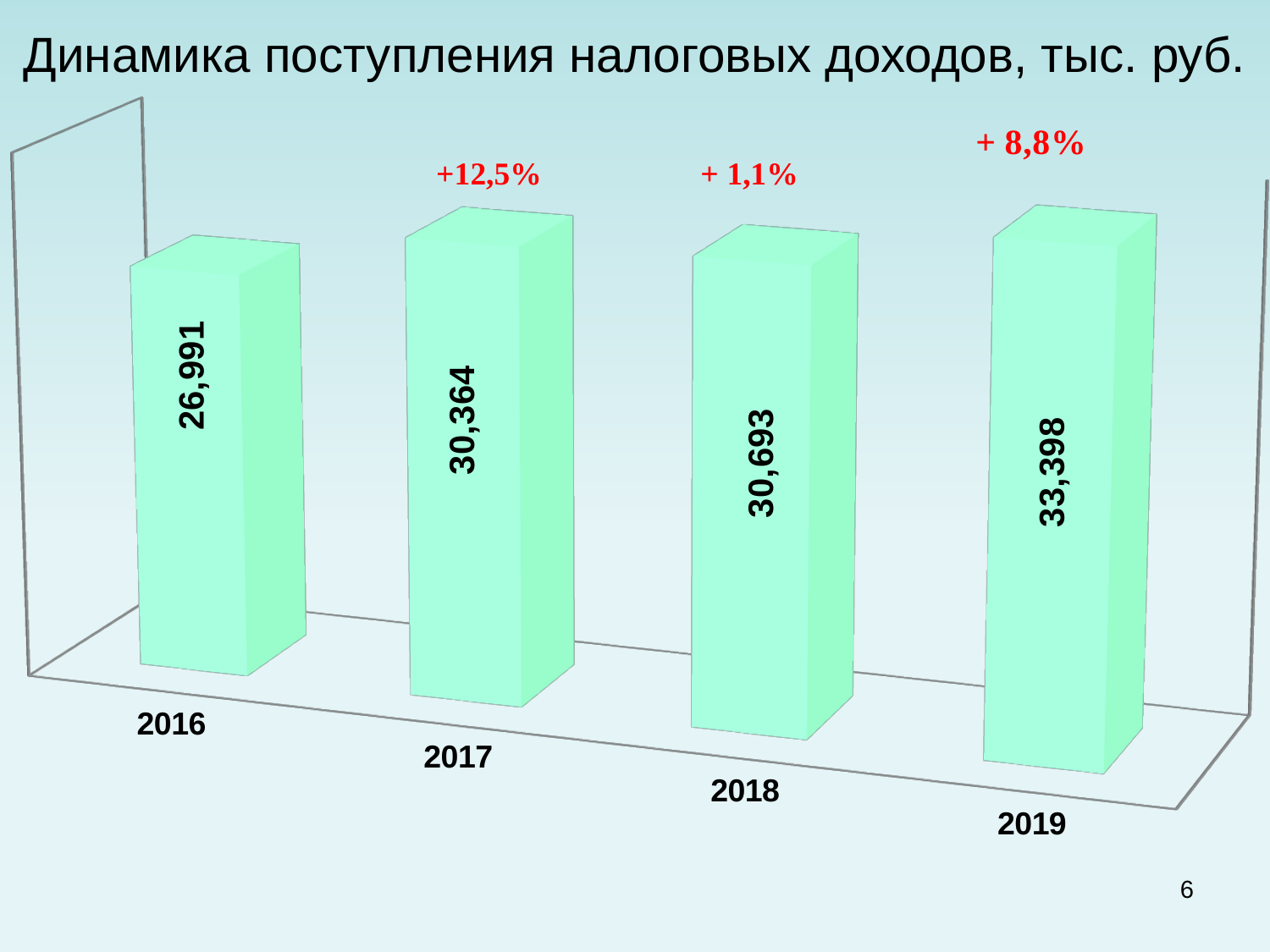
What is the value for 2016? 26,991 What is the value for 2017? 30,364 What kind of chart is shown on the slide? Bar chart Which year has the highest value? 2019 Do the values rise or fall from 2016 to 2019? Rise Which year has the lowest value? 2016 What is the difference between the values for 2019 and 2016? 6,407 What is the value for 2019? 33,398 Which is larger, the value for 2019 or the value for 2017? 2019 What is the value for 2018? 30,693 How many years are shown on the chart? 4 What is the difference between the values for 2017 and 2016? 3,373